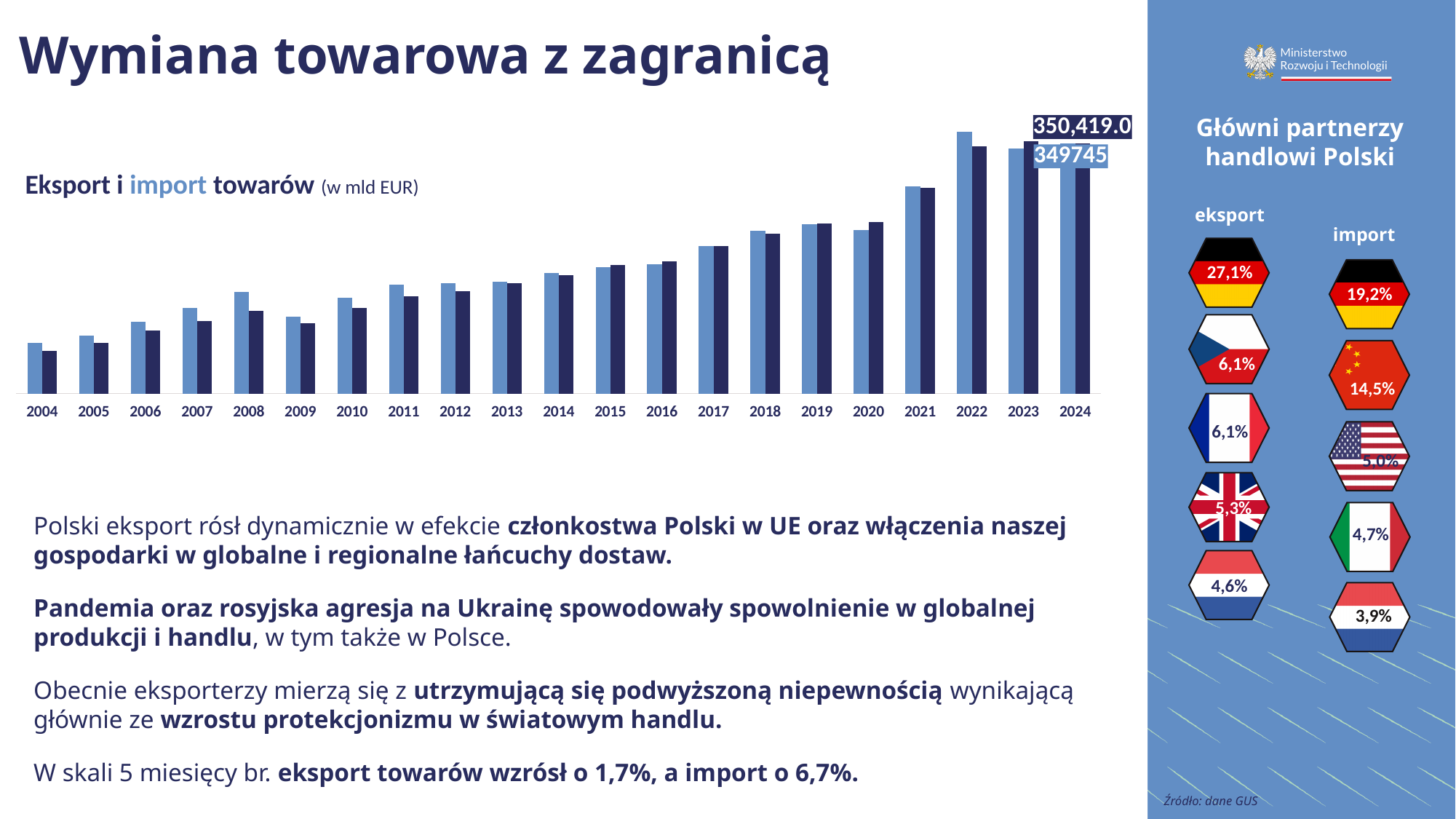
In the 'Eksport i import towarów' chart, which series is drawn in the lighter blue colour? import In the 'Eksport i import towarów' chart, is export or import larger in 2004? import What unit is given in the title of the 'Eksport i import towarów' chart? mld EUR How many years are shown on the x axis of the 'Eksport i import towarów' chart? 21 What type of chart is used to show 'Eksport i import towarów'? bar chart In the 'Eksport i import towarów' chart, what is the import value labelled for 2024? 349745 How many data series does the 'Eksport i import towarów' chart plot? 2 In the 'Eksport i import towarów' chart, what is the export value labelled for 2024? 350,419.0 In the 'Eksport i import towarów' chart, is export or import larger in 2022? import In the 'Eksport i import towarów' chart, which year has the lowest export bar? 2004 Do the export values in the 'Eksport i import towarów' chart generally rise or fall from 2004 to 2024? rise In the 'Eksport i import towarów' chart, which year has the highest export bar? 2023